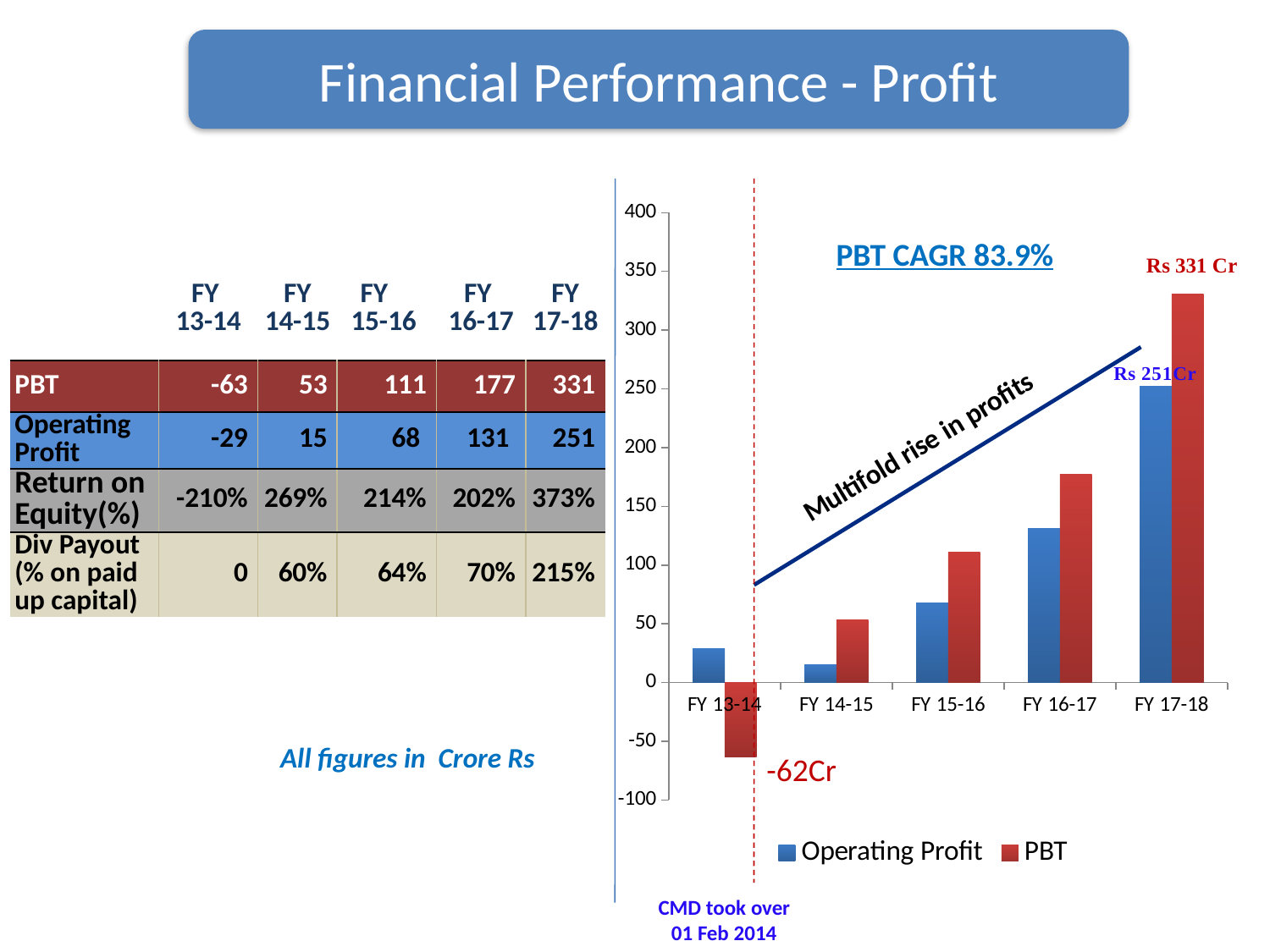
Which fiscal year has the highest PBT bar on the chart? FY 17-18 How many series does the chart legend list? 2 What is the Operating Profit value labelled for FY 17-18 on the chart? Rs 251 Cr What PBT CAGR is annotated on the chart? 83.9% What is the PBT value labelled for FY 17-18 on the chart? Rs 331 Cr What is the difference between the PBT and Operating Profit labels for FY 17-18 on the chart? 80 Is the PBT bar for FY 16-17 greater or less than 150? greater For FY 17-18, which is larger on the chart: PBT or Operating Profit? PBT Do the PBT bars rise or fall from FY 14-15 to FY 17-18? rise What kind of chart is shown on the slide? bar chart Is the Operating Profit bar for FY 15-16 greater or less than 100? less How many fiscal years are shown on the x axis of the chart? 5